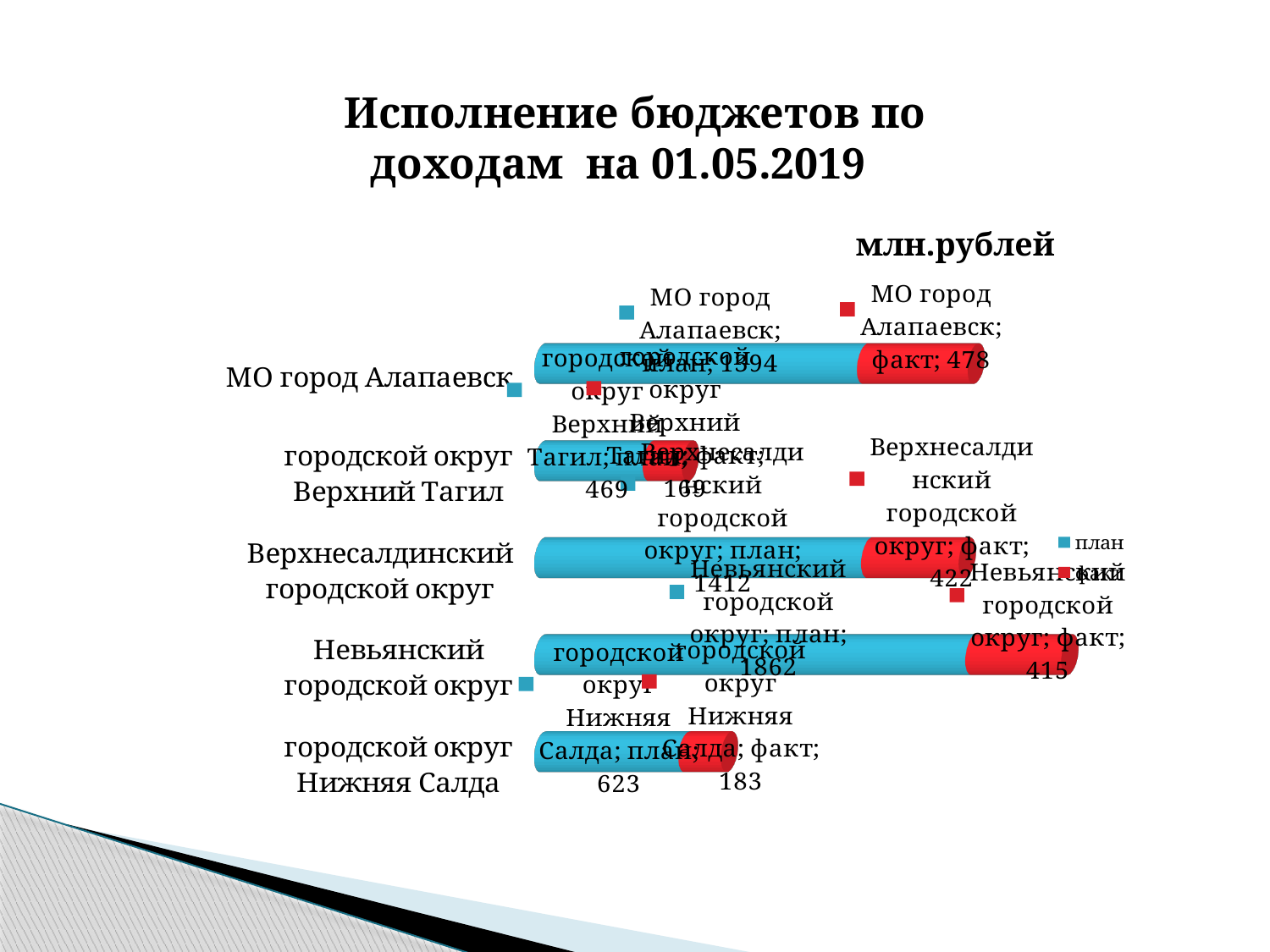
What is the факт value for МО город Алапаевск? 478 How many categories (municipalities) are shown in the chart? 5 Which is larger: the план value for Верхнесалдинский городской округ or the план value for городской округ Нижняя Салда? Верхнесалдинский городской округ What is the факт value for Верхнесалдинский городской округ? 422 Which category has the lowest факт value? городской округ Верхний Тагил What is the difference between план and факт for городской округ Верхний Тагил? 300 What kind of chart is shown on the slide? bar chart What is the факт value for городской округ Нижняя Салда? 183 How many series does the legend list? 2 What is the план value for МО город Алапаевск? 1394 Which category has the highest план value? Невьянский городской округ What is the план value for Невьянский городской округ? 1862